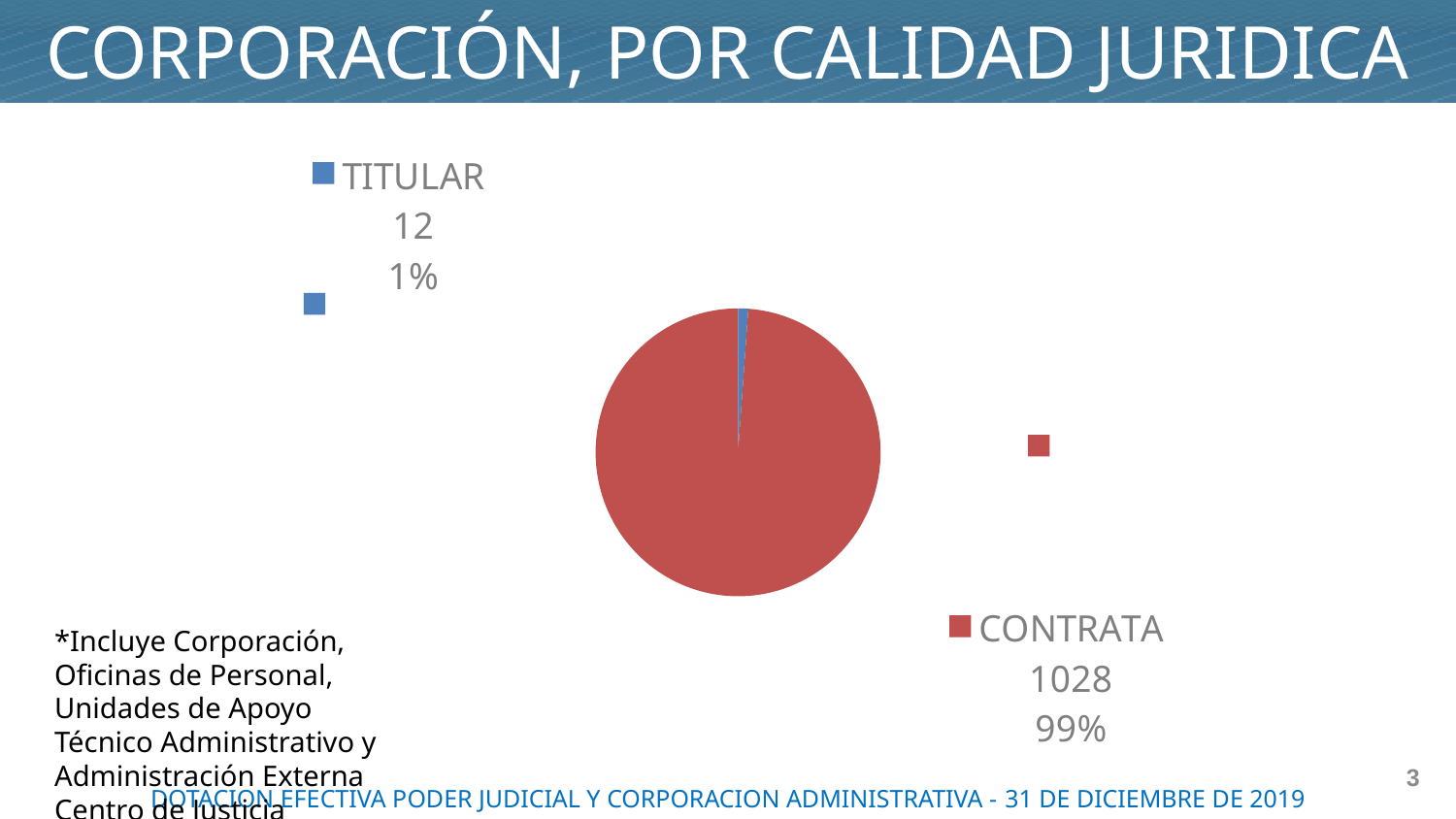
Which is larger, the value for TITULAR or the value for CONTRATA? CONTRATA What colour is the CONTRATA slice of the pie? red Which category has the smallest slice of the pie? TITULAR What is the title of the slide containing the chart? CORPORACIÓN, POR CALIDAD JURIDICA What is the value for CONTRATA? 1028 What percentage share does CONTRATA have in the pie? 99% Which category has the largest slice of the pie? CONTRATA What is the difference between the values for CONTRATA and TITULAR? 1016 What is the total of the two labelled slices, TITULAR and CONTRATA? 1040 What is the value for TITULAR? 12 What percentage share does TITULAR have in the pie? 1% What kind of chart is shown on the slide? pie chart